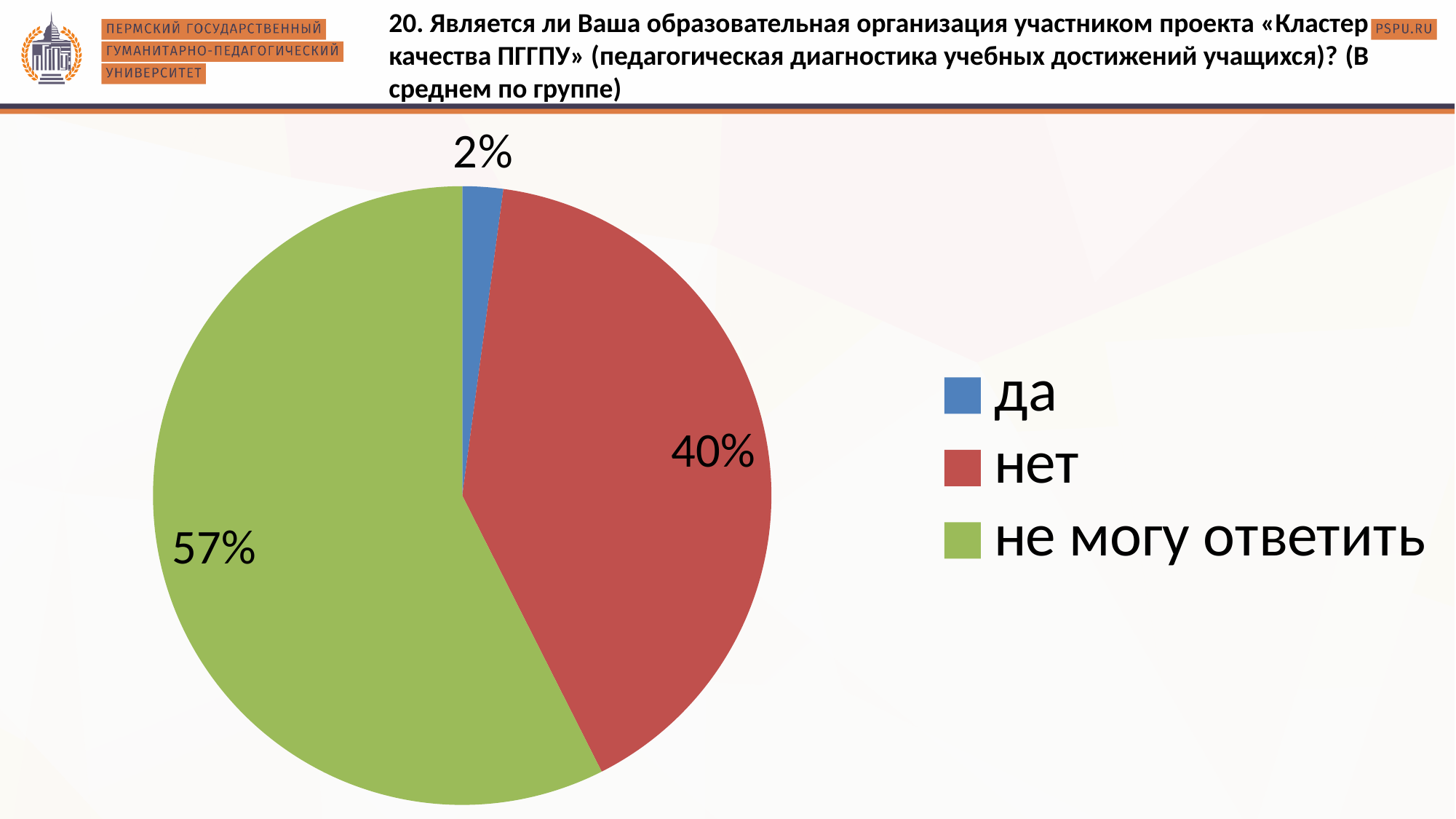
What percentage of respondents answered «нет»? 40% What is the difference in percentage points between «не могу ответить» and «нет»? 17 How many entries does the legend list? 3 Which answer has the smallest share of the pie? да What percentage of respondents answered «не могу ответить»? 57% Which share is larger, «нет» or «да»? нет What percentage of respondents answered «да»? 2% What is the difference in percentage points between «нет» and «да»? 38 How many slices does the pie chart have? 3 What colour is the slice for «нет»? red What kind of chart is shown on the slide? pie chart Which answer has the largest share of the pie? не могу ответить